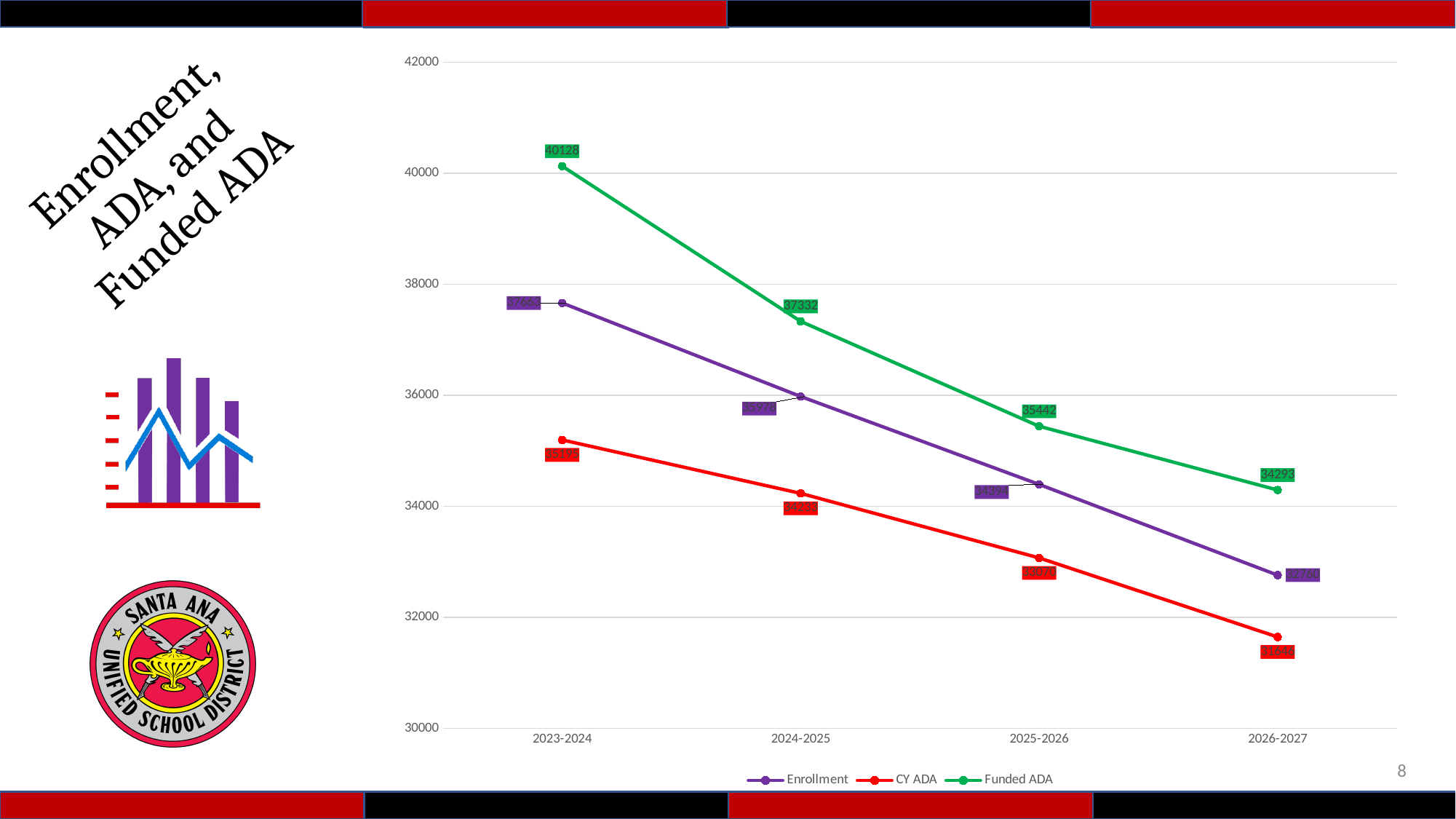
Do the Funded ADA values rise or fall from 2023-2024 to 2026-2027? fall In 2025-2026, which is larger: Enrollment or CY ADA? Enrollment In which school year is Funded ADA highest? 2023-2024 What is the difference between the Funded ADA values for 2023-2024 and 2026-2027? 5835 What is the Enrollment value for 2026-2027? 32760 What is the Funded ADA value for 2023-2024? 40128 What kind of chart is shown on the slide? line chart What is the CY ADA value for 2026-2027? 31646 How many school years are plotted along the x axis? 4 Which colour is used for the Funded ADA series? green What is the Funded ADA value for 2026-2027? 34293 How many series does the chart's legend list? 3